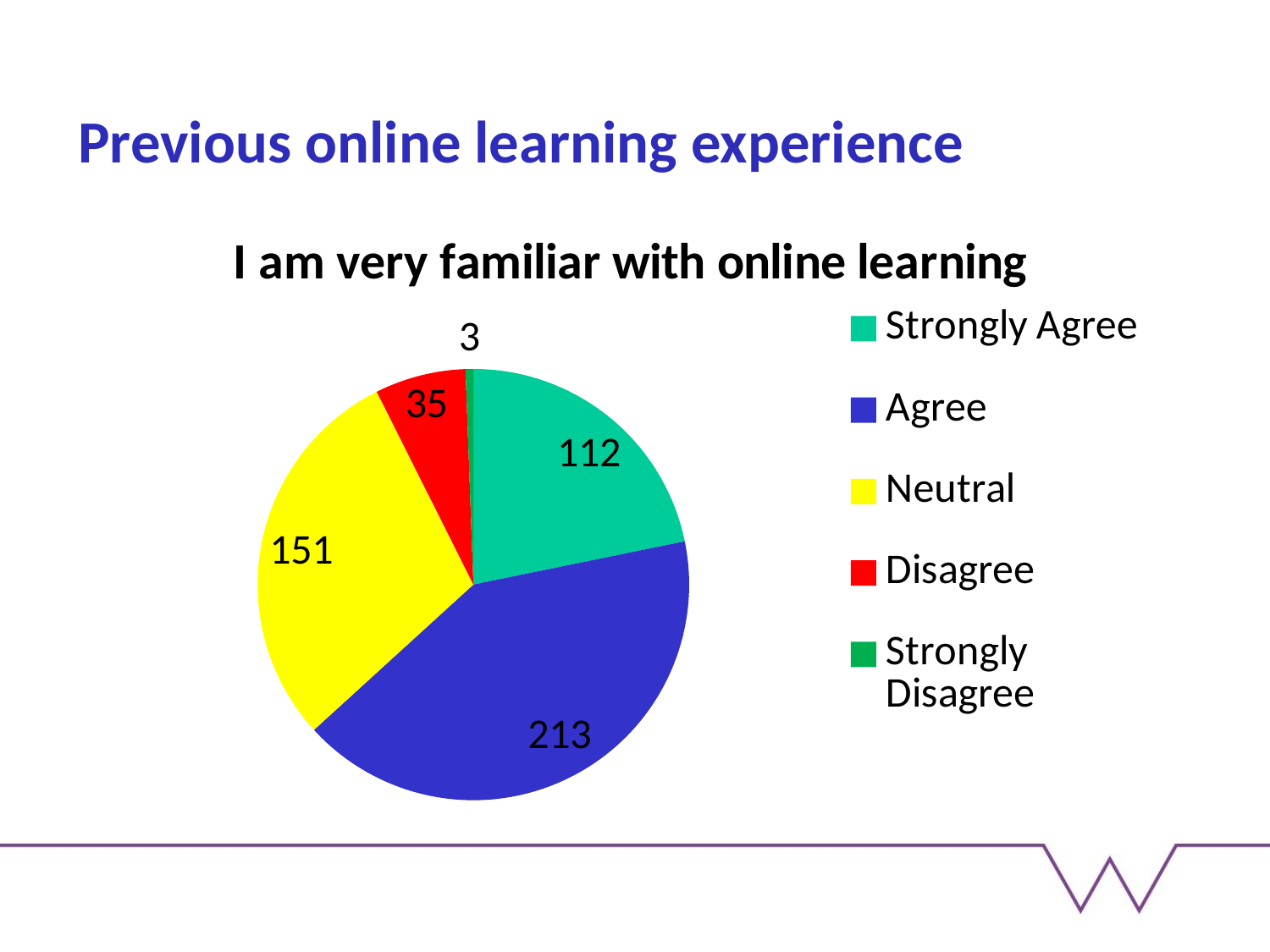
Which category has the smallest slice in the pie chart? Strongly Disagree Which is larger, the value for Strongly Agree or the value for Neutral? Neutral What is the value for Neutral in the pie chart? 151 How many categories does the pie chart show? 5 What is the value for Agree in the pie chart? 213 What kind of chart is shown on the slide? Pie chart What is the value for Strongly Disagree in the pie chart? 3 What is the total of all the values in the pie chart? 514 What is the value for Disagree in the pie chart? 35 What is the difference between the values for Agree and Neutral? 62 What is the title of the chart? I am very familiar with online learning Which category has the largest slice in the pie chart? Agree